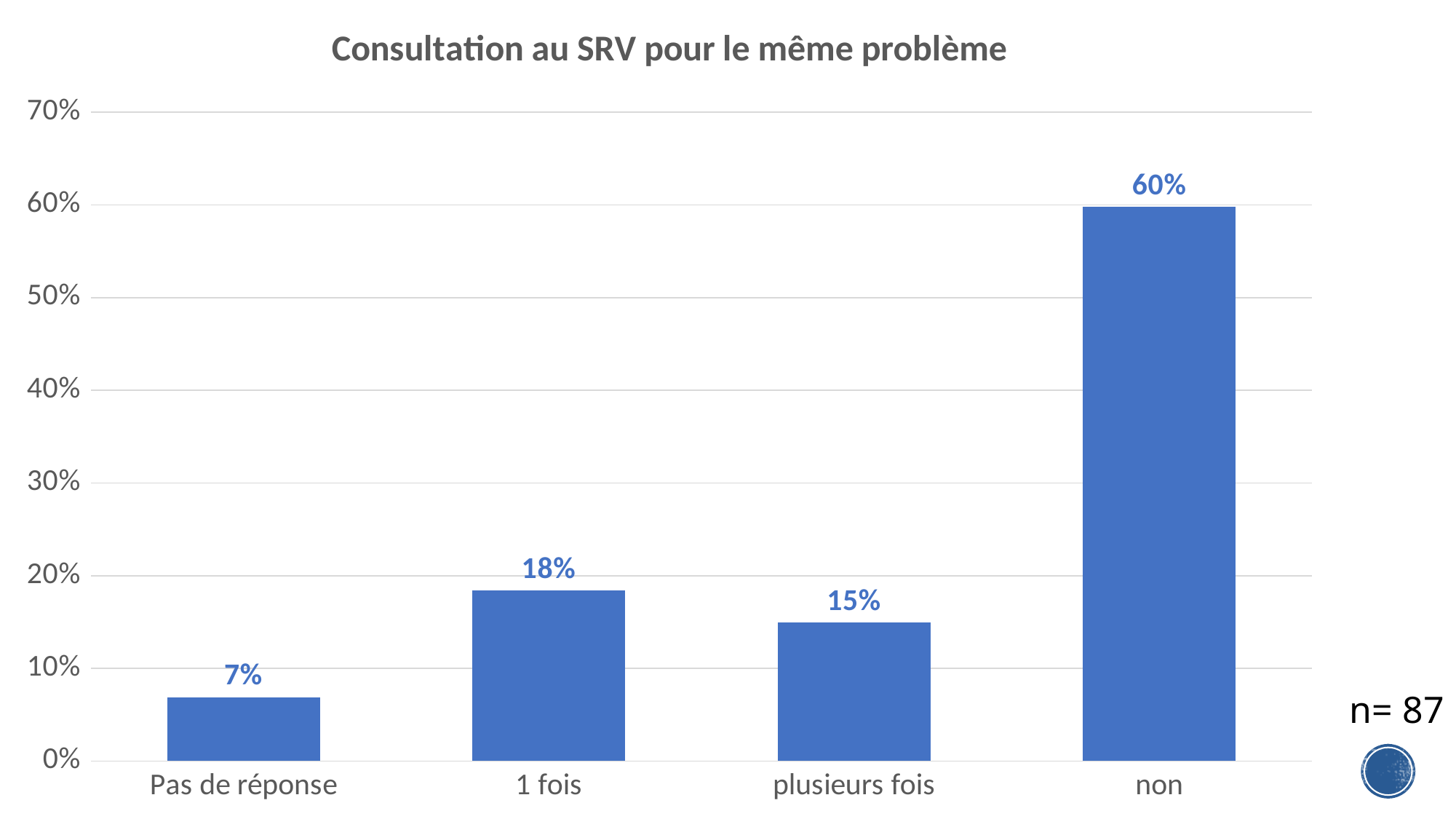
What is the value for "plusieurs fois"? 15% What kind of chart is shown on the slide? bar chart Which is larger, the value for "1 fois" or the value for "plusieurs fois"? 1 fois What is the value for "1 fois"? 18% How many categories are shown on the x axis? 4 Which category has the lowest value? Pas de réponse What is the difference between the values for "non" and "1 fois"? 42% What is the value for "non"? 60% What is the value for "Pas de réponse"? 7% Which category has the highest value? non Is the value for "non" greater or less than 50%? greater What is the title of the chart? Consultation au SRV pour le même problème